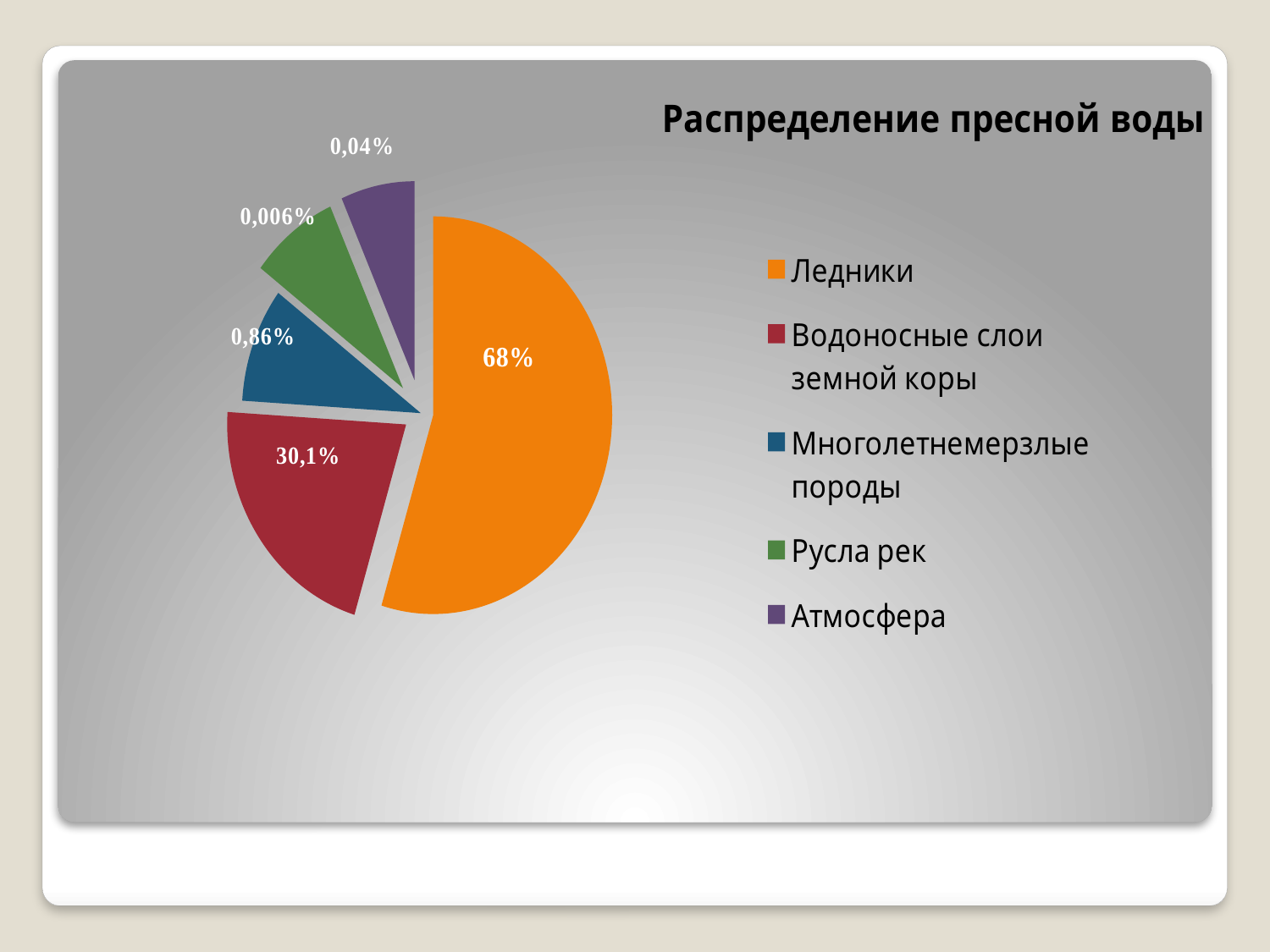
Which category has the smallest share of fresh water? Русла рек What percentage is shown for Водоносные слои земной коры? 30,1% Which is larger, the share of Водоносные слои земной коры or Многолетнемерзлые породы? Водоносные слои земной коры What percentage of fresh water is in Ледники? 68% What value is shown for Многолетнемерзлые породы? 0,86% What is the difference between the shares of Ледники and Водоносные слои земной коры? 37,9% Which category has the largest share of fresh water? Ледники What type of chart is shown on the slide? pie chart What value is shown for Атмосфера? 0,04% What is the title of the chart? Распределение пресной воды What value is shown for Русла рек? 0,006% How many categories does the legend list? 5